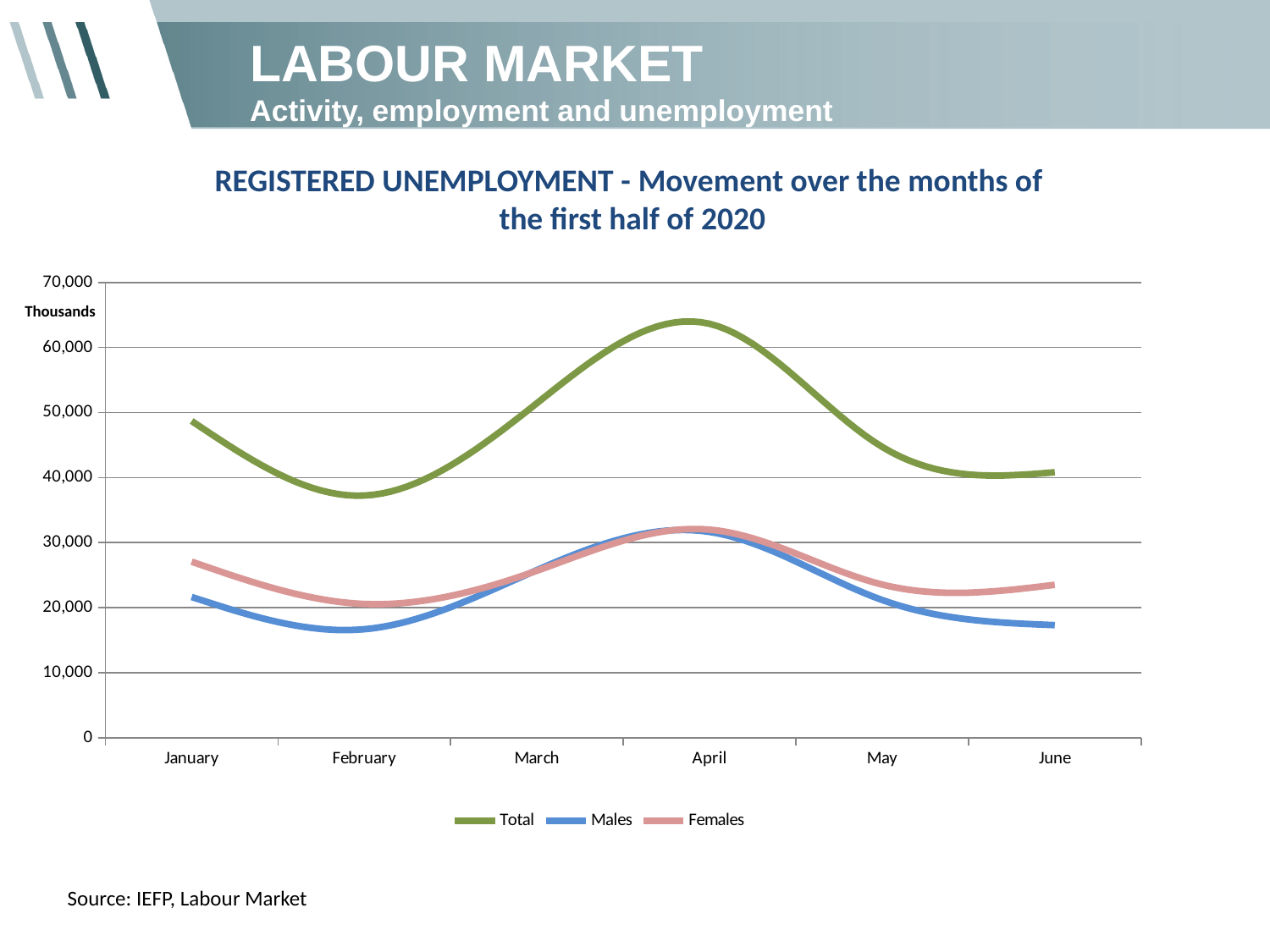
Is the Total value for February greater or less than 40,000? less Does the Total series rise or fall from April to June? Falls In which month does the Total series reach its highest value? April Is the Total value for April greater or less than 60,000? greater In January, which is larger: the Males value or the Females value? Females Is the Females value for April greater or less than 30,000? greater What is the title of the chart? REGISTERED UNEMPLOYMENT - Movement over the months of the first half of 2020 How many months are plotted along the x axis? 6 In which month does the Total series reach its lowest value? February How many series does the legend list? 3 What kind of chart is shown on the slide? Line chart